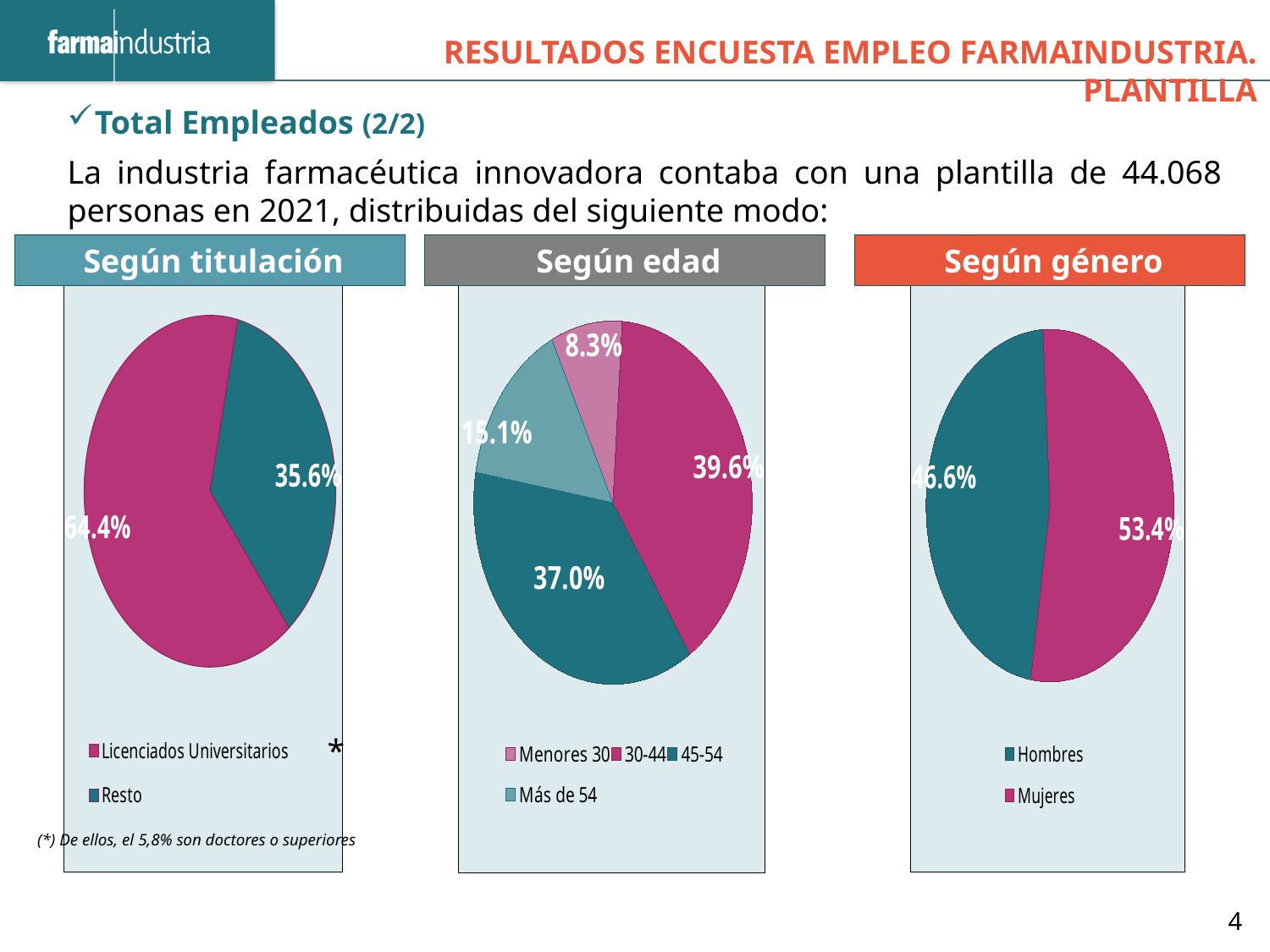
In the 'Según edad' chart, which age group has the largest share? 30-44 In the 'Según titulación' chart, what is the value for Resto? 35.6% In the 'Según género' chart, which is larger, Hombres or Mujeres? Mujeres In the 'Según titulación' chart, what is the difference between Licenciados Universitarios and Resto? 28.8% In the 'Según edad' chart, which age group has the smallest share? Menores 30 In the 'Según edad' chart, what is the value for the 30-44 group? 39.6% How many categories does the 'Según edad' chart show? 4 In the 'Según titulación' chart, what share of employees are Licenciados Universitarios? 64.4% In the 'Según edad' chart, what is the value for Menores 30? 8.3% In the 'Según edad' chart, what is the difference between the 45-54 share and the Más de 54 share? 21.9% In the 'Según género' chart, what is the value for Mujeres? 53.4% What kind of chart is the 'Según género' chart? Pie chart